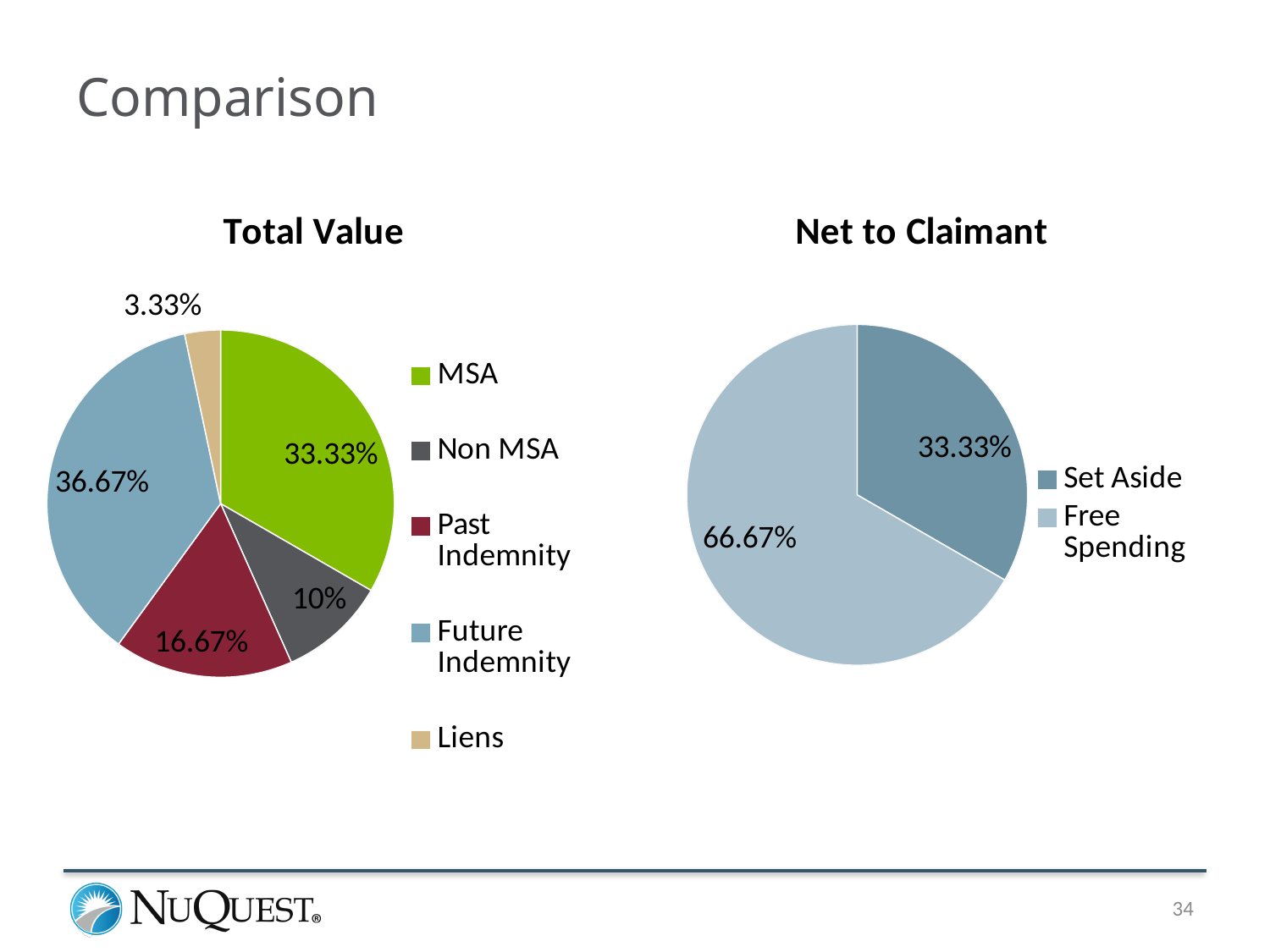
In the Total Value chart, what share does Future Indemnity have? 36.67% In the Total Value chart, which category has the smallest share? Liens In the Total Value chart, which is larger, Non MSA or Past Indemnity? Past Indemnity In the Net to Claimant chart, what share does Free Spending have? 66.67% In the Total Value chart, how many categories does the legend list? 5 In the Total Value chart, what share does MSA have? 33.33% In the Total Value chart, what share does Past Indemnity have? 16.67% In the Total Value chart, what share does Liens have? 3.33% In the Net to Claimant chart, what share does Set Aside have? 33.33% In the Net to Claimant chart, what is the difference between the Free Spending and Set Aside shares? 33.34% What type of chart is the Net to Claimant chart? Pie chart In the Total Value chart, which category has the largest share? Future Indemnity